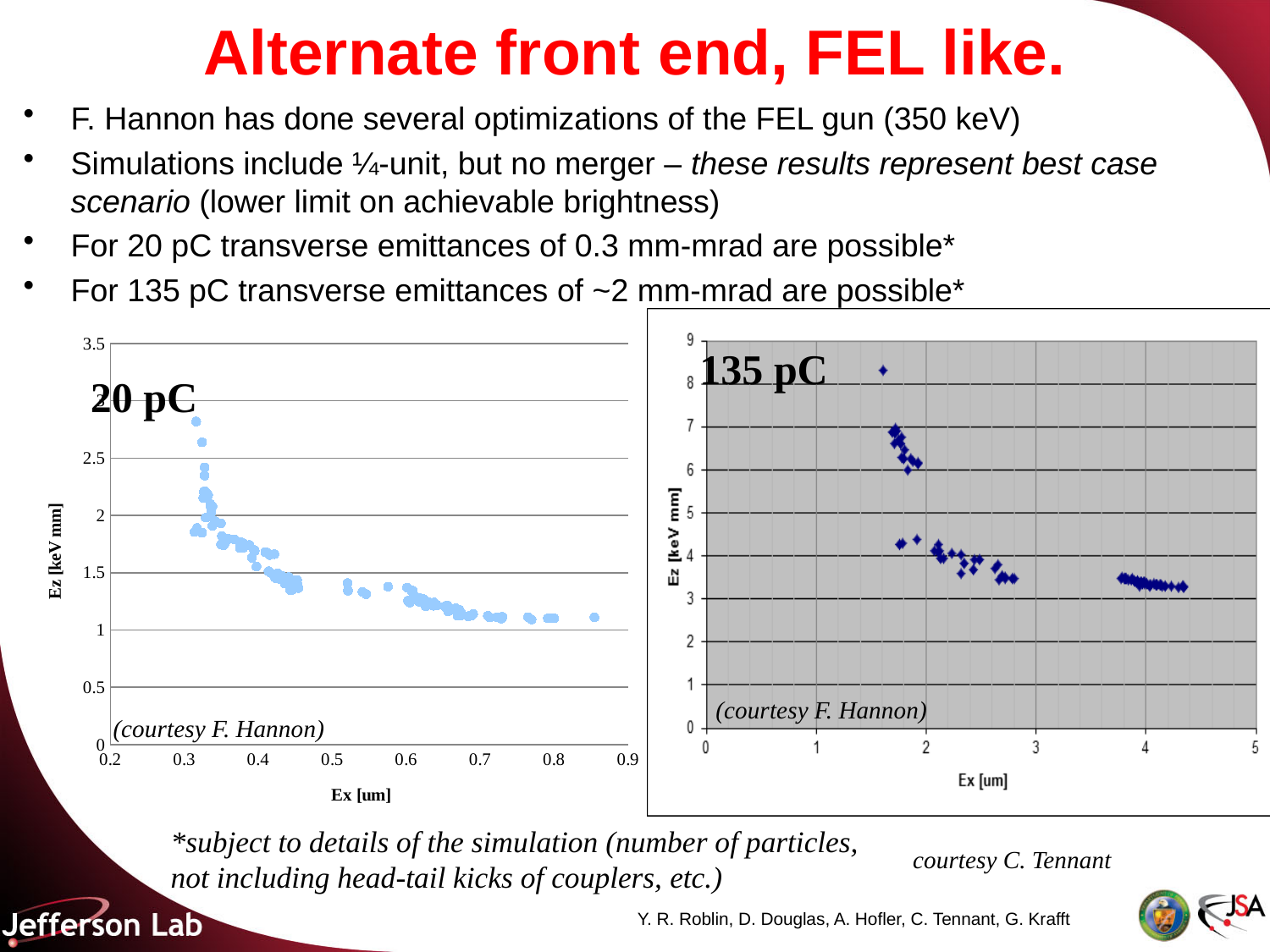
In the 135 pC chart, which has the larger Ez value: the points near Ex = 2 or the points near Ex = 4? the points near Ex = 2 In the 20 pC chart, which has the larger Ez value: the points near Ex = 0.3 or the points near Ex = 0.8? the points near Ex = 0.3 In the 135 pC chart, is the highest plotted Ez value greater or less than 8? greater In the 20 pC chart, is the highest plotted Ez value greater or less than 2.5? greater In the 135 pC chart, are the Ez values of the points near Ex = 4 greater or less than 4? less What kind of chart is the 20 pC chart on the left? scatter chart What is the y-axis label of the 135 pC chart? Ez [keV mm] In the 20 pC chart, do the Ez values rise or fall as Ex increases? fall What is the x-axis label of the 20 pC chart? Ex [um] In the 135 pC chart, do the Ez values rise or fall as Ex increases? fall What kind of chart is the 135 pC chart on the right? scatter chart